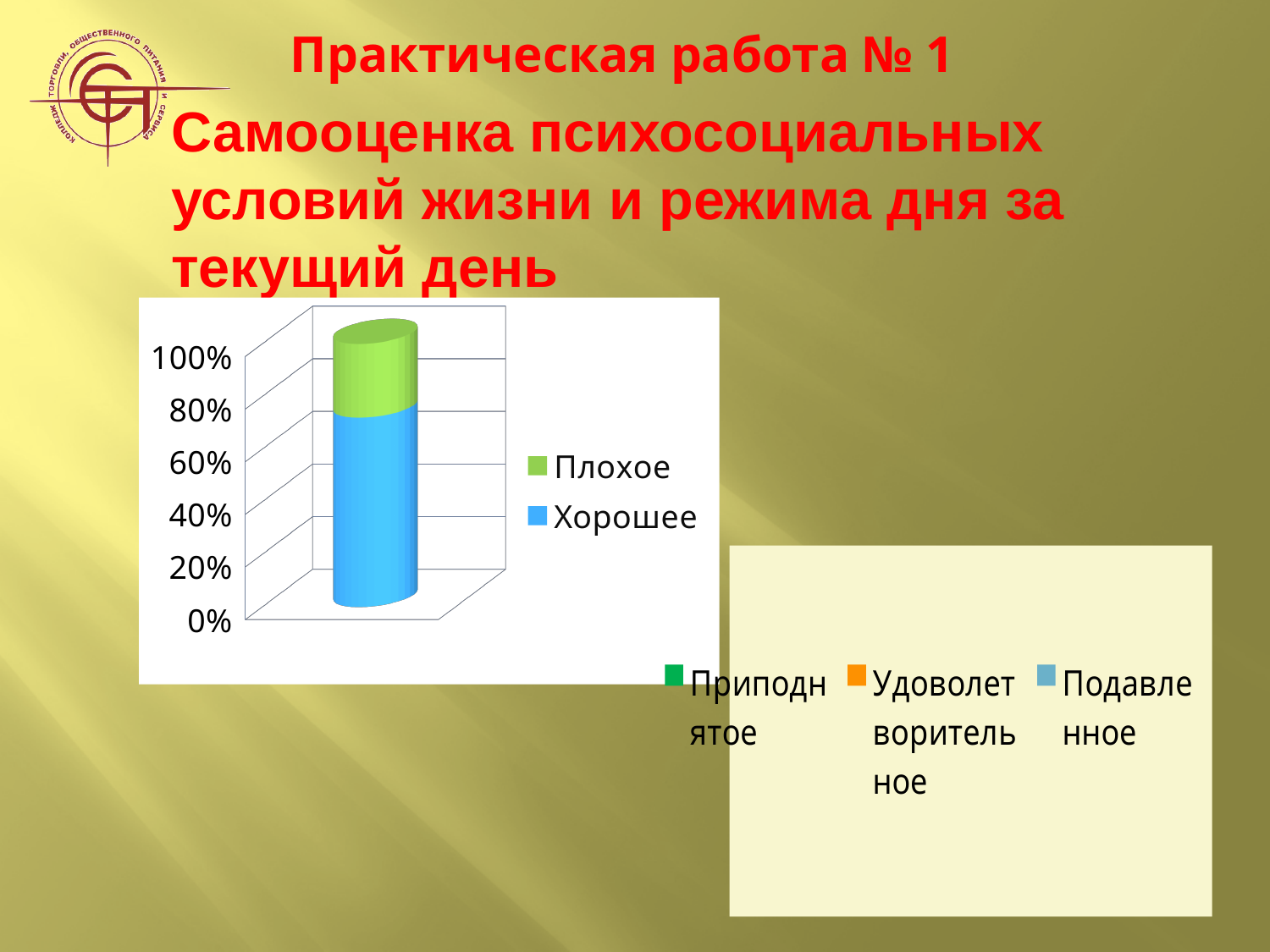
Which series in the left chart takes up the larger part of the bar, Плохое or Хорошее? Хорошее How many bars are plotted in the left chart? 1 Which series has the smallest share of the bar in the left chart? Плохое In the left chart, is the value for Плохое greater or less than 40%? less What colour represents the series Плохое in the left chart? green How many entries does the legend of the chart on the right of the slide list? 3 What kind of chart is shown on the left of the slide? bar chart What is the highest tick shown on the vertical axis of the left chart? 100% In the left chart, is the value for Хорошее greater or less than 60%? greater How many series does the legend of the left chart list? 2